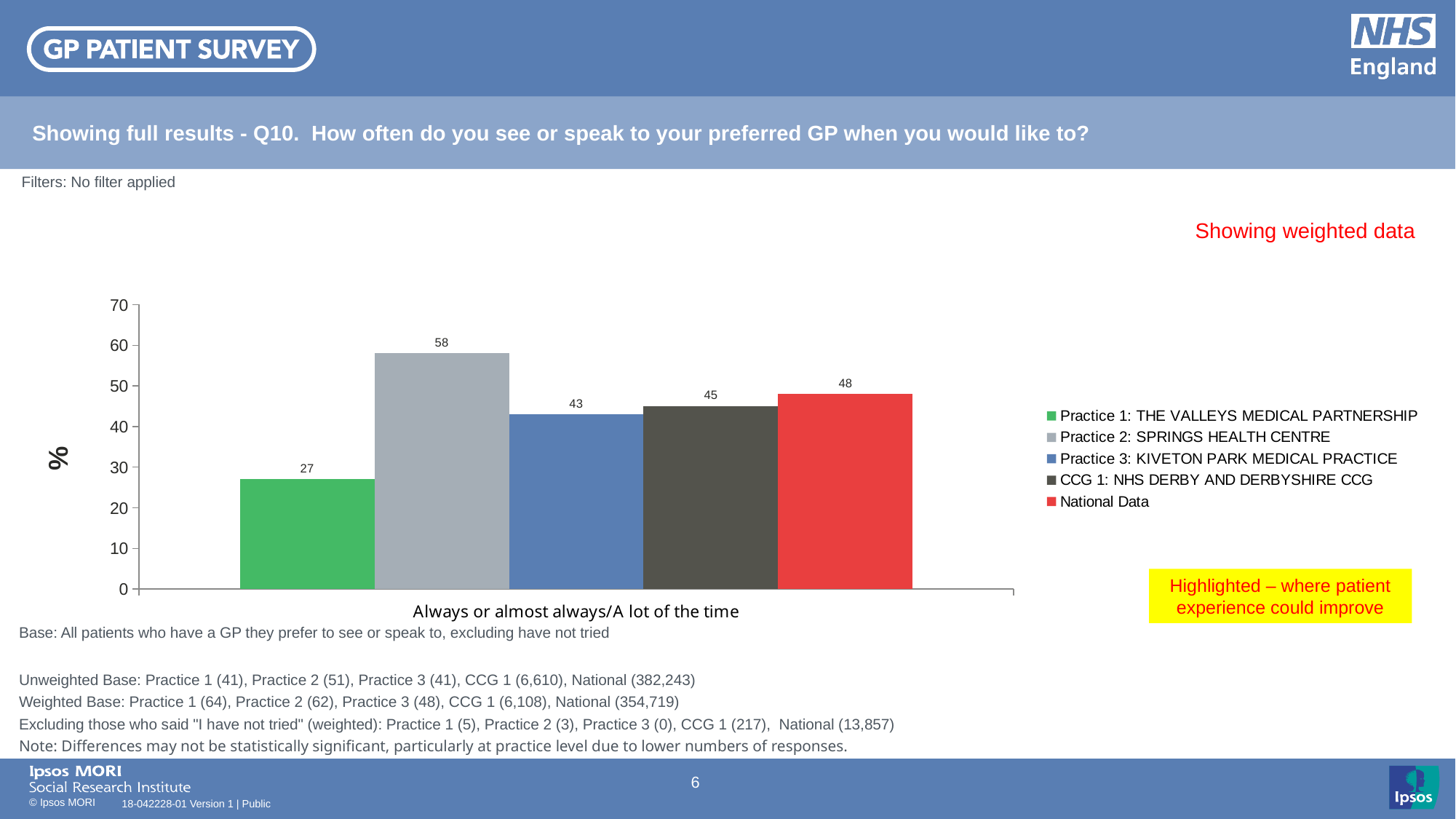
What is the difference between the values for Practice 2: SPRINGS HEALTH CENTRE and Practice 1: THE VALLEYS MEDICAL PARTNERSHIP? 31 What is the value for National Data? 48 Is the value for Practice 3: KIVETON PARK MEDICAL PRACTICE greater or less than 50? less Which series has the lowest value? Practice 1: THE VALLEYS MEDICAL PARTNERSHIP What is the value for Practice 3: KIVETON PARK MEDICAL PRACTICE? 43 Which series has the highest value? Practice 2: SPRINGS HEALTH CENTRE Which is larger, the value for CCG 1: NHS DERBY AND DERBYSHIRE CCG or the value for National Data? National Data What kind of chart is shown on the slide? bar chart What is the value for Practice 2: SPRINGS HEALTH CENTRE? 58 What is the value for Practice 1: THE VALLEYS MEDICAL PARTNERSHIP? 27 What is the label on the x axis of the chart? Always or almost always/A lot of the time How many series does the legend list? 5